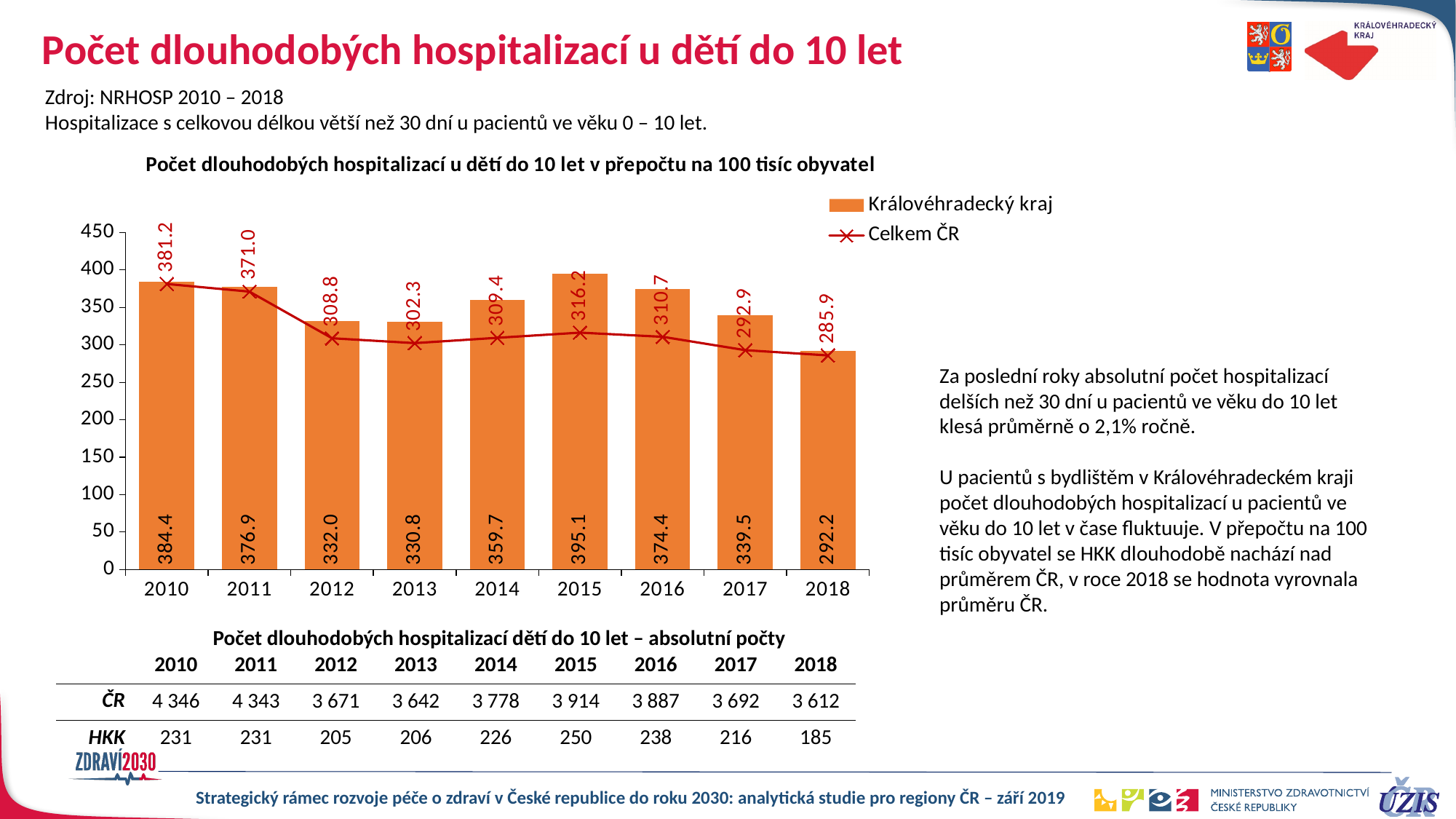
Which is larger in 2014: the Královéhradecký kraj value or the Celkem ČR value? Královéhradecký kraj In which year is the Celkem ČR value lowest? 2018 What kind of chart is shown on the slide? Bar chart combined with a line series In which year is the Královéhradecký kraj value highest? 2015 Is the Královéhradecký kraj value for 2013 greater or less than 350? less How many years are shown on the x axis of the chart? 9 What is the value for Celkem ČR in 2012? 308.8 What is the difference between the Královéhradecký kraj value and the Celkem ČR value in 2015? 78.9 What is the value for Královéhradecký kraj in 2018? 292.2 Does the Celkem ČR line rise or fall overall from 2010 to 2018? Fall What is the value for Královéhradecký kraj in 2015? 395.1 How many series does the chart legend list? 2